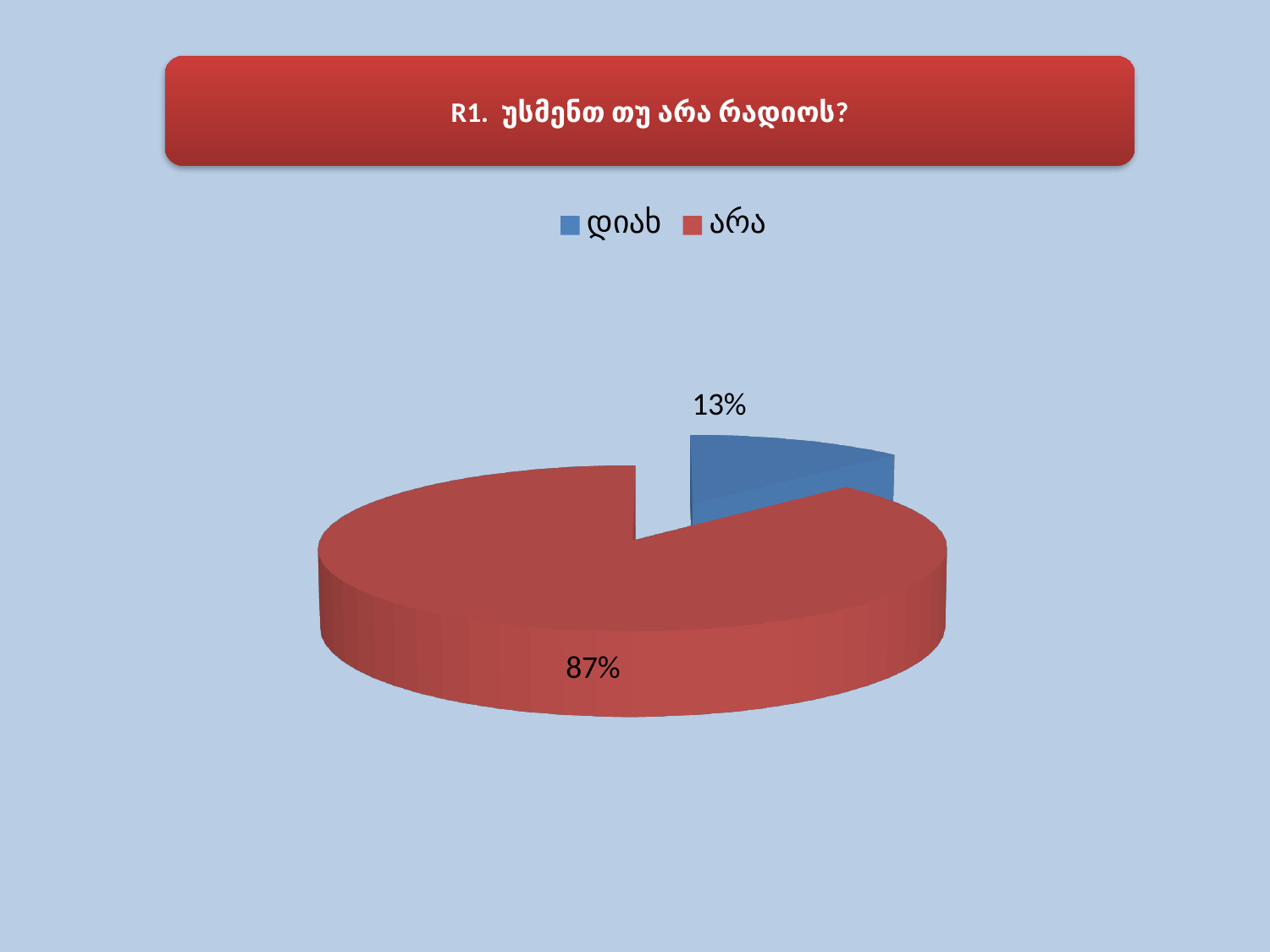
What percentage is shown for დიახ? 13% What is the title of the chart? R1. უსმენთ თუ არა რადიოს? Which is larger, the share for დიახ or the share for არა? არა What percentage is shown for არა? 87% Is the share for არა greater or less than 50%? greater Which category has the smallest share of the pie? დიახ How many entries does the legend list? 2 What is the difference between the shares for არა and დიახ? 74% How many slices does the pie chart have? 2 What type of chart is shown on the slide? Pie chart What colour is the slice for დიახ? Blue Which category has the largest share of the pie? არა